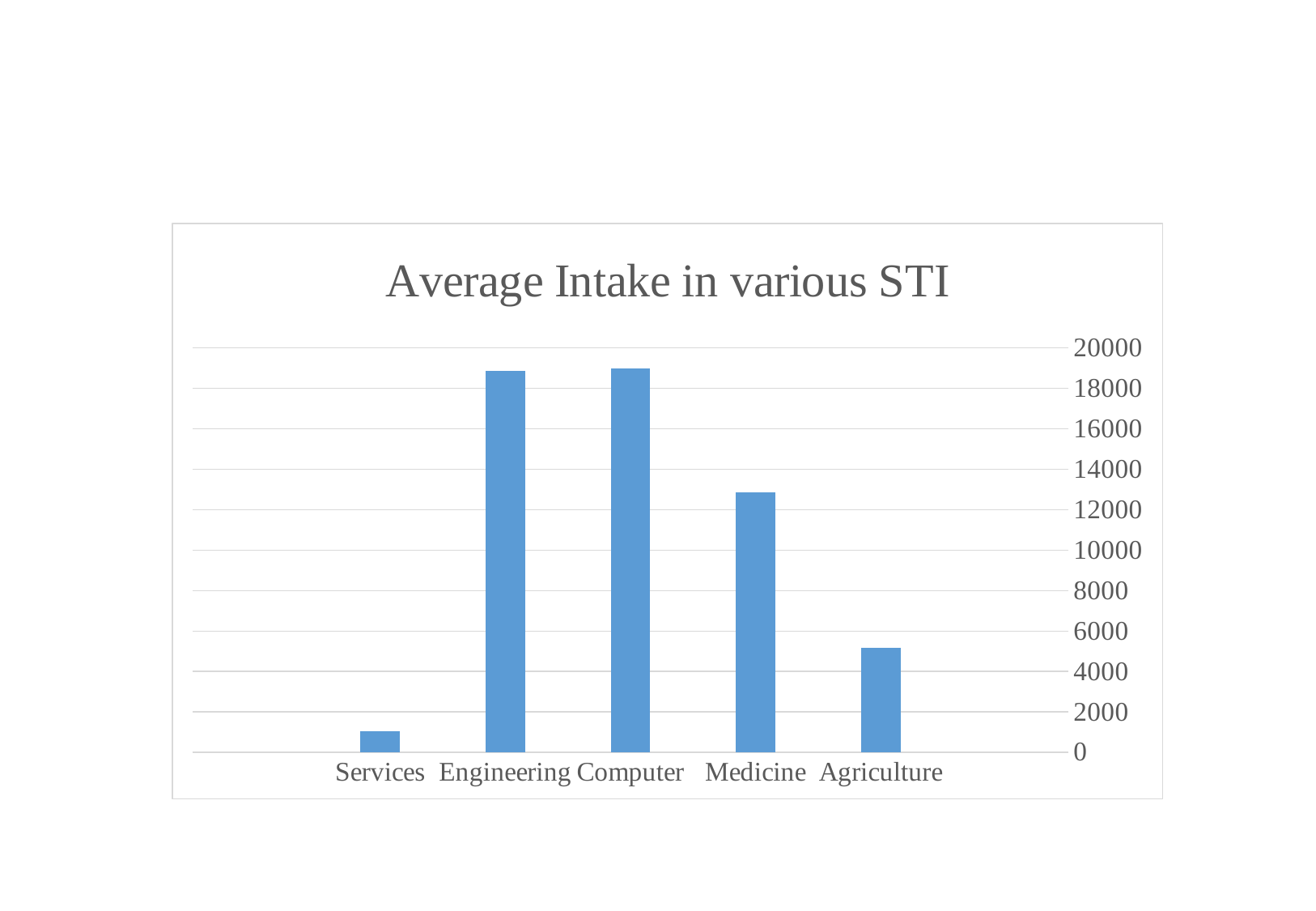
Is the value for Agriculture greater or less than 6000? less Is the value for Agriculture greater or less than 4000? greater Which has a higher average intake, Engineering or Medicine? Engineering Is the value for Services greater or less than 2000? less Which category has the lowest average intake? Services Which has a higher average intake, Medicine or Agriculture? Medicine Which has a higher average intake, Services or Agriculture? Agriculture What is the title of the chart? Average Intake in various STI How many categories are shown on the x axis of the chart? 5 What kind of chart is shown on the slide? bar chart